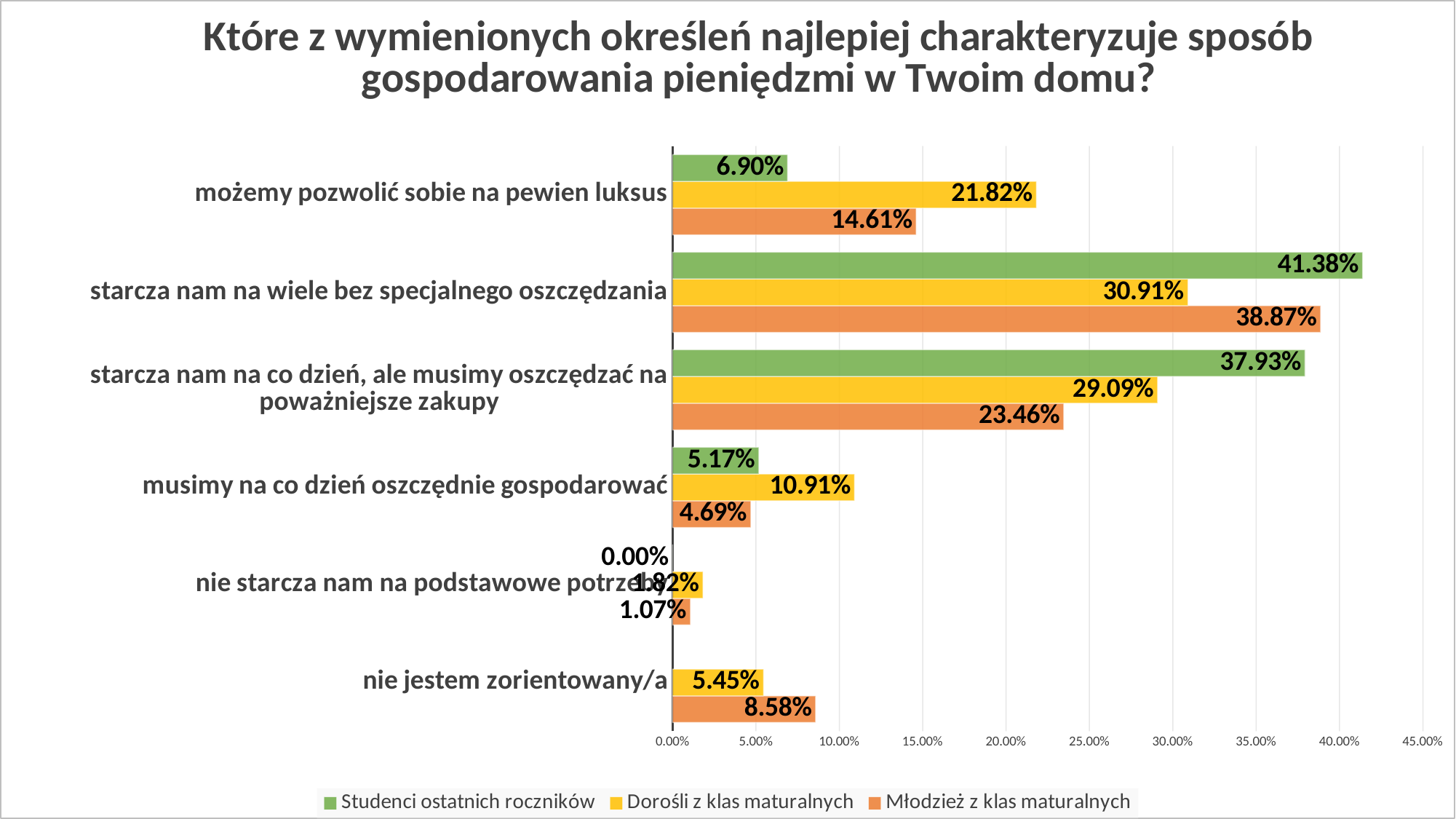
Which category has the highest value for Młodzież z klas maturalnych? starcza nam na wiele bez specjalnego oszczędzania Which colour represents Dorośli z klas maturalnych in the legend? yellow Is the value for Młodzież z klas maturalnych in the category 'starcza nam na co dzień, ale musimy oszczędzać na poważniejsze zakupy' greater or less than 25.00%? less What kind of chart is shown on the slide? bar chart What is the value for Studenci ostatnich roczników in the category 'starcza nam na wiele bez specjalnego oszczędzania'? 41.38% What is the difference between the Studenci ostatnich roczników and Dorośli z klas maturalnych values in the category 'starcza nam na co dzień, ale musimy oszczędzać na poważniejsze zakupy'? 8.84% How many series does the legend list? 3 What is the value for Młodzież z klas maturalnych in the category 'nie jestem zorientowany/a'? 8.58% How many categories are shown on the chart? 6 In the category 'musimy na co dzień oszczędnie gospodarować', which series has the larger value: Studenci ostatnich roczników or Młodzież z klas maturalnych? Studenci ostatnich roczników Which category has the lowest value for Dorośli z klas maturalnych? nie starcza nam na podstawowe potrzeby What is the value for Dorośli z klas maturalnych in the category 'możemy pozwolić sobie na pewien luksus'? 21.82%